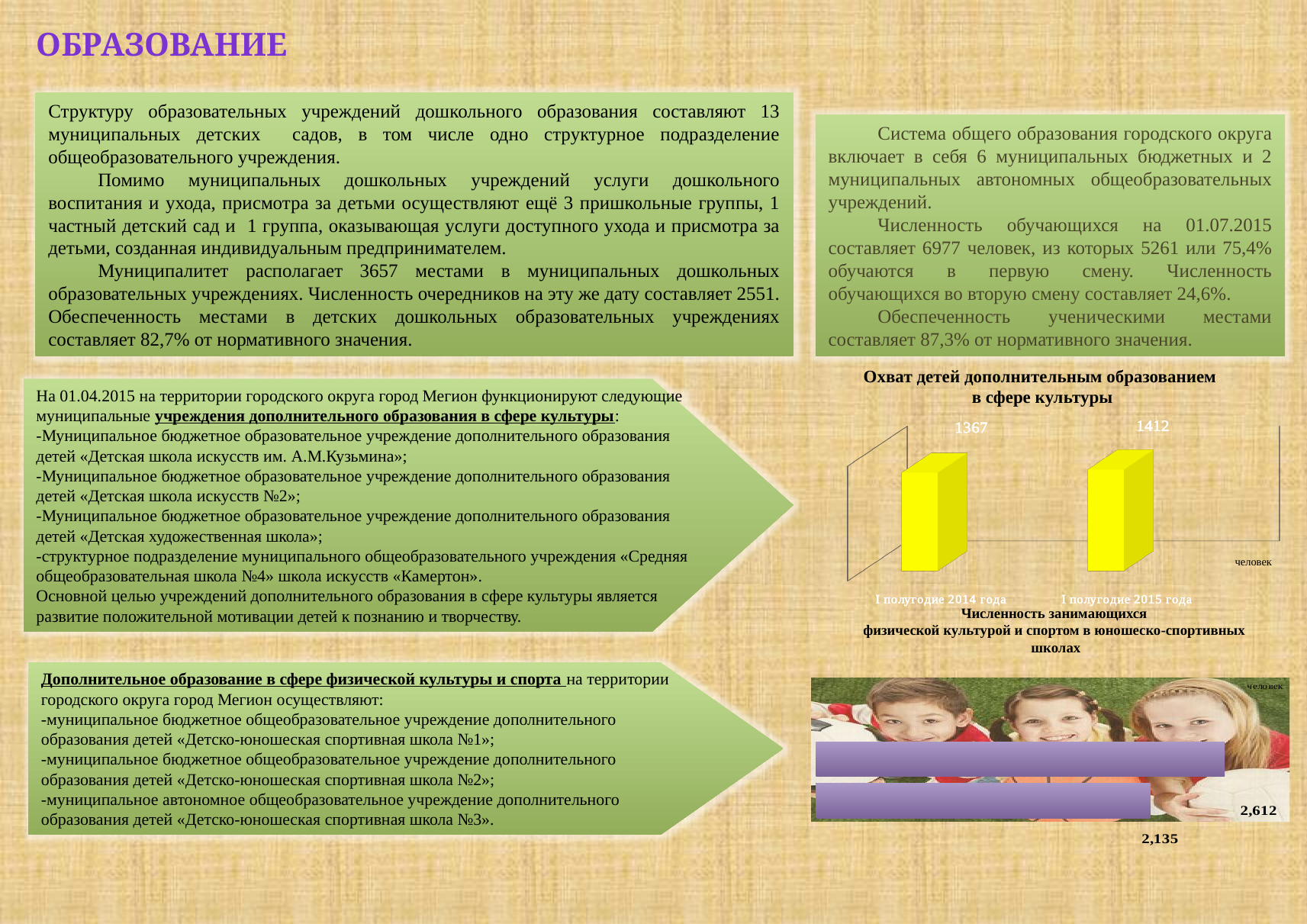
In the chart 'Охват детей дополнительным образованием в сфере культуры', what is the value for I полугодие 2015 года? 1412 What type of chart is 'Численность занимающихся физической культурой и спортом в юношеско-спортивных школах'? Bar chart In the chart 'Охват детей дополнительным образованием в сфере культуры', which period has the lower value? I полугодие 2014 года In the chart 'Охват детей дополнительным образованием в сфере культуры', which period has the higher value? I полугодие 2015 года In the chart 'Охват детей дополнительным образованием в сфере культуры', what colour are the bars? Yellow In the chart 'Численность занимающихся физической культурой и спортом в юношеско-спортивных школах', what is the difference between the two labelled values, 2,612 and 2,135? 477 In the chart 'Охват детей дополнительным образованием в сфере культуры', how many bars are plotted? 2 What type of chart is 'Охват детей дополнительным образованием в сфере культуры'? Bar chart In the chart 'Охват детей дополнительным образованием в сфере культуры', what is the difference between the values for I полугодие 2015 года and I полугодие 2014 года? 45 In the chart 'Охват детей дополнительным образованием в сфере культуры', do the values rise or fall from I полугодие 2014 года to I полугодие 2015 года? Rise In the chart 'Охват детей дополнительным образованием в сфере культуры', what is the value for I полугодие 2014 года? 1367 In the chart 'Численность занимающихся физической культурой и спортом в юношеско-спортивных школах', how many bars are plotted? 2